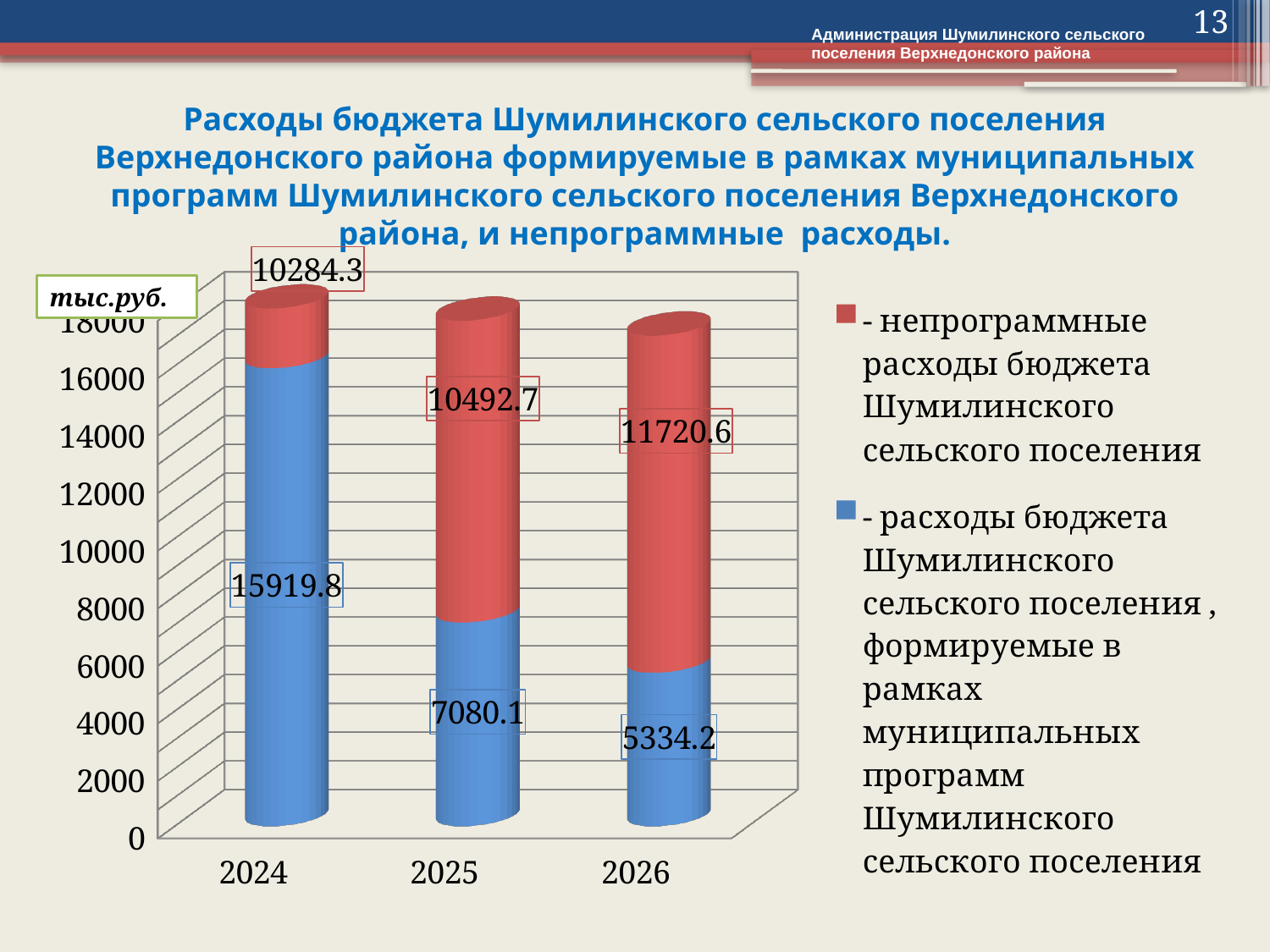
What is the total of the stacked bar for 2025? 17572.8 What is the value of the program expenses (blue series) for 2024? 15919.8 What kind of chart is shown on the slide? stacked bar chart Do the program expenses (blue series) rise or fall from 2024 to 2026? fall Which year has the lowest value for the non-program expenses (red series)? 2024 How many series does the legend list? 2 How many years are shown on the x axis? 3 Which year has the highest value for the program expenses (blue series)? 2024 Which is larger in 2025: the non-program expenses (red) or the program expenses (blue)? non-program expenses (red) What is the value of the program expenses (blue series) for 2025? 7080.1 What is the value of the non-program expenses (red series) for 2026? 11720.6 What is the difference between the program expenses (blue series) in 2024 and 2025? 8839.7